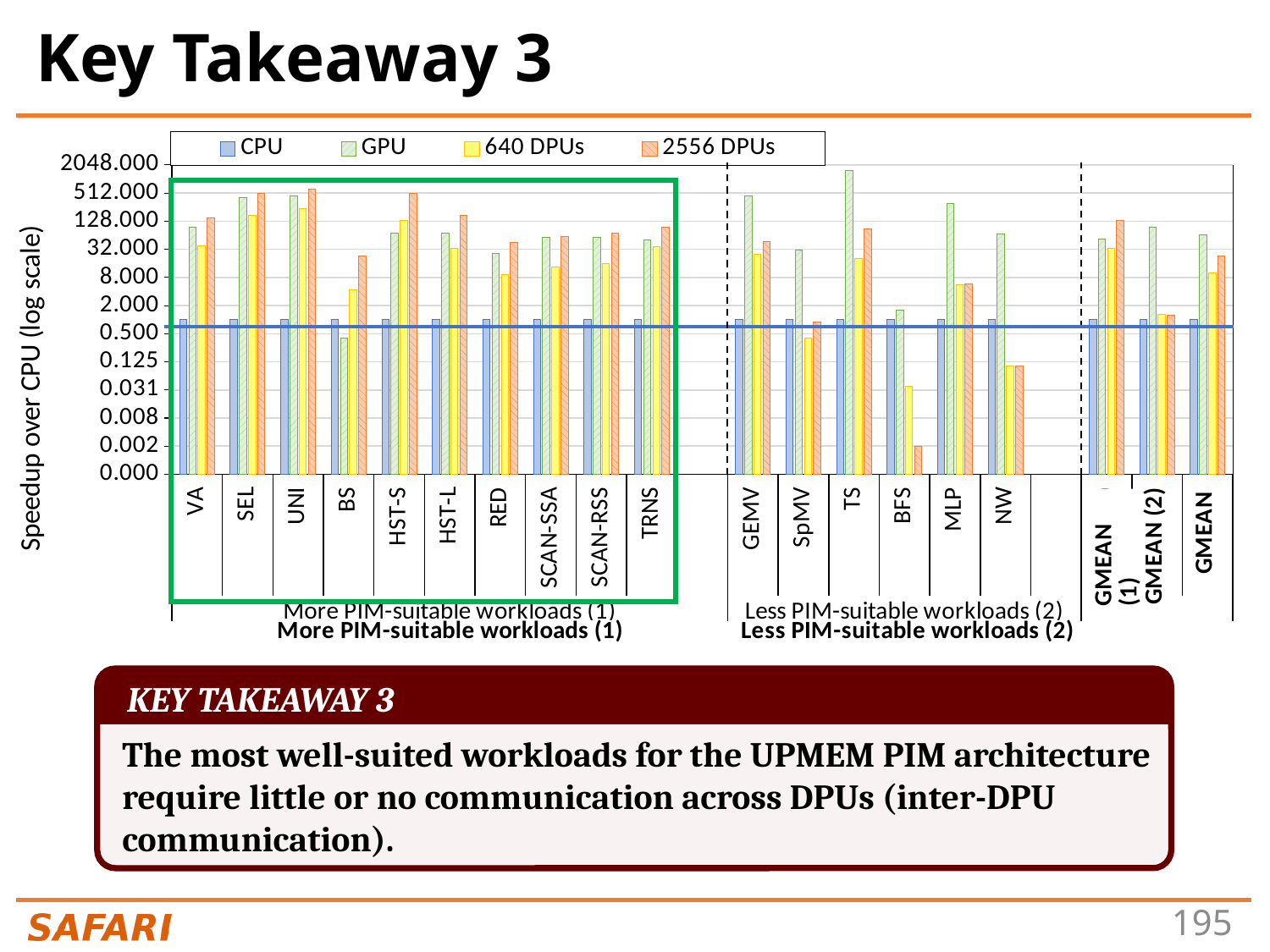
How many series does the legend list? 4 Is the GPU value for TS greater or less than 512? greater What is the label of the y axis? Speedup over CPU (log scale) Is the 2556 DPUs value for BFS greater or less than 0.031? less For NW, which is larger: the GPU bar or the 640 DPUs bar? GPU Which series has the highest bar for TS? GPU What kind of chart is shown on the slide? bar chart Is the 640 DPUs value for NW greater or less than 0.5? less Which workload has the lowest 2556 DPUs bar? BFS For BS, which is larger: the GPU bar or the 2556 DPUs bar? 2556 DPUs Among all workloads, which one has the highest GPU bar? TS